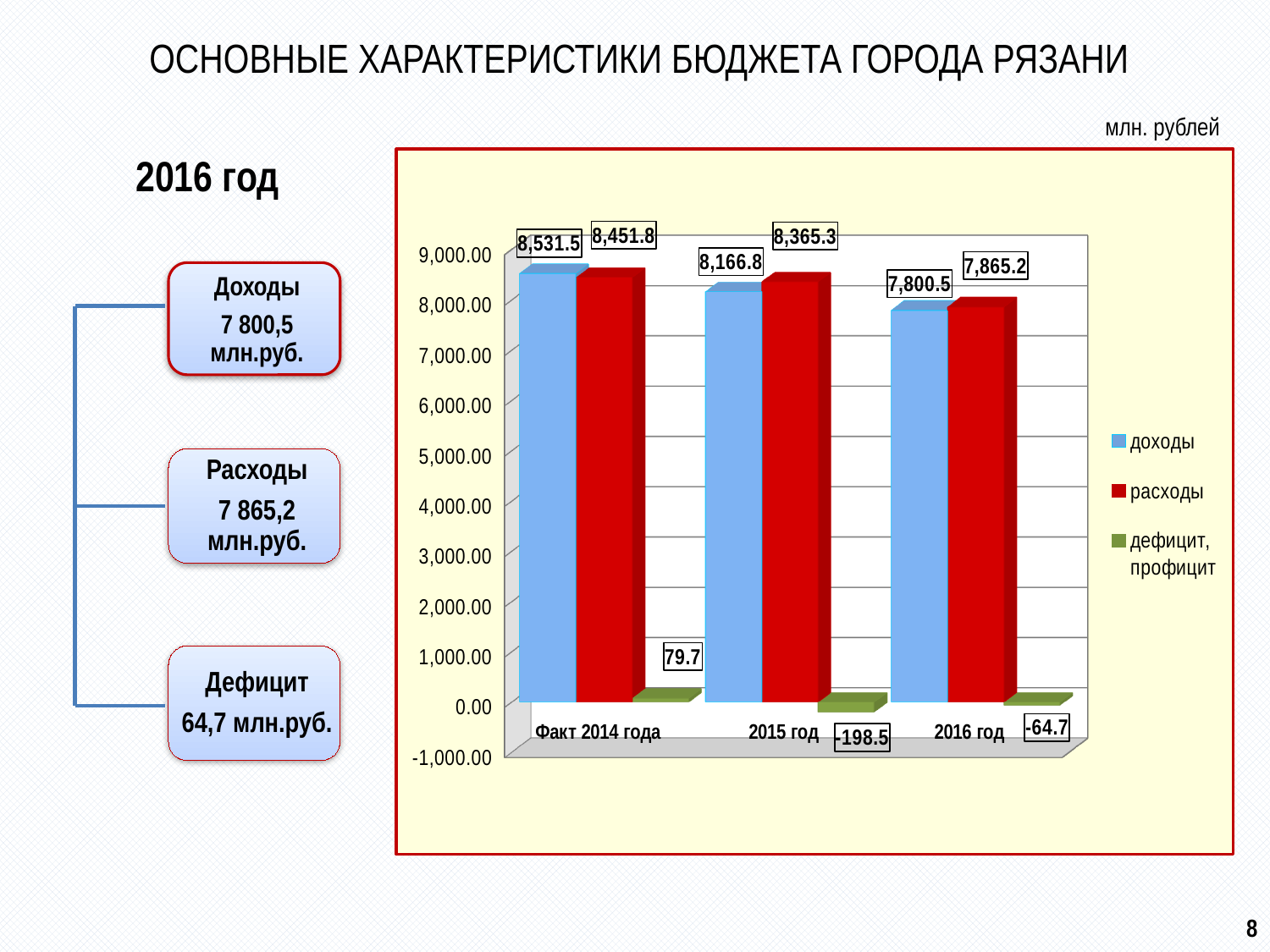
What is the value of дефицит, профицит for 2015 год? -198.5 How many series does the legend list? 3 Do the values for доходы rise or fall from Факт 2014 года to 2016 год? fall Which is larger for 2015 год: доходы or расходы? расходы What kind of chart is shown on the slide? bar chart Which category has the lowest value for расходы? 2016 год How many categories are shown on the x axis? 3 What is the value of расходы for 2015 год? 8,365.3 What is the difference between расходы and доходы for 2016 год? 64.7 Which category has the highest value for доходы? Факт 2014 года What is the value of расходы for 2016 год? 7,865.2 What is the value of доходы for Факт 2014 года? 8,531.5